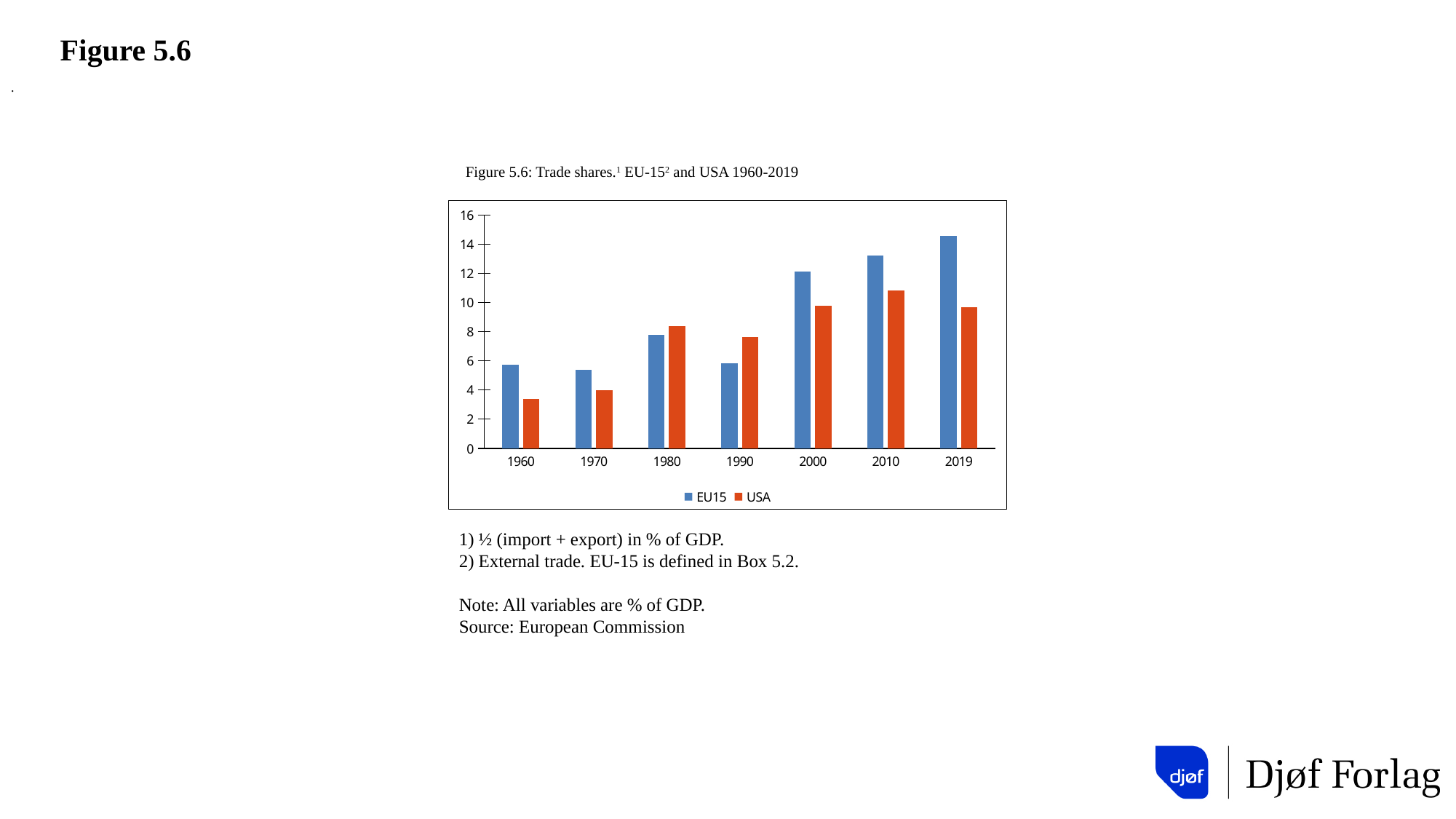
In which year is the EU15 trade share highest? 2019 How many series does the legend list? 2 In which year is the USA trade share lowest? 1960 Is the value for EU15 in 2019 greater or less than 14? greater Which colour represents the USA series in the chart? orange-red In 1980, which is larger, the EU15 or the USA trade share? USA What kind of chart is shown on the slide? bar chart Is the value for USA in 1960 greater or less than 4? less Is the value for USA in 2010 greater or less than 10? greater In 2019, which is larger, the EU15 or the USA trade share? EU15 How many years are shown on the x axis? 7 In which year is the USA trade share highest? 2010